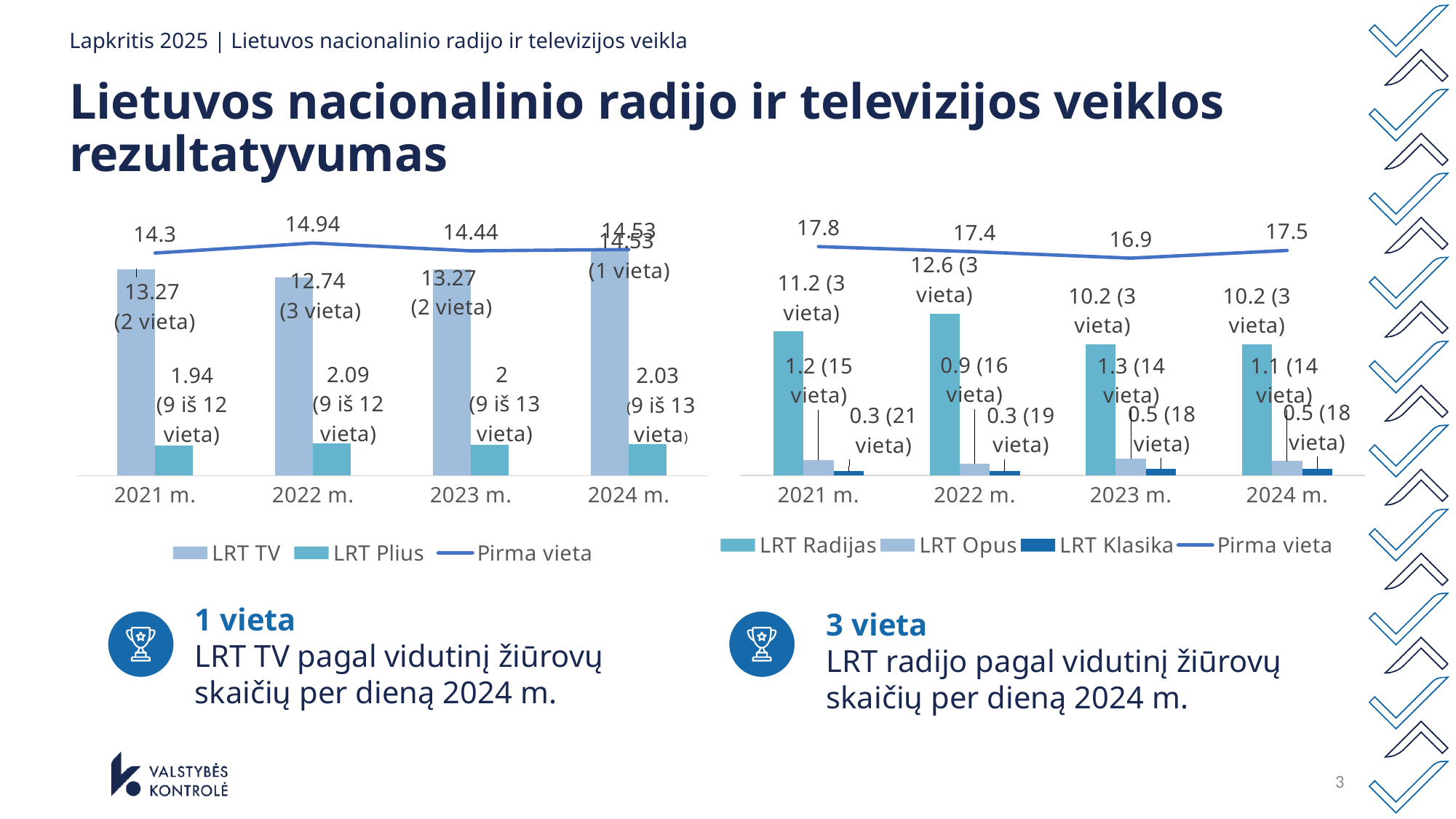
In the left chart, what is the value of the Pirma vieta line in 2022 m.? 14.94 In the left chart, what is the value for LRT TV in 2024 m.? 14.53 In the left chart, what is the value for LRT Plius in 2022 m.? 2.09 In the right chart, what is the value for LRT Radijas in 2022 m.? 12.6 In the left chart, how many series does the legend list? 3 In the right chart, how many years are shown on the x axis? 4 What kind of chart is the right chart? Combined bar and line chart In the left chart, what is the difference between the LRT TV values in 2024 m. and 2023 m.? 1.26 In the right chart, what is the value of the Pirma vieta line in 2023 m.? 16.9 In the right chart, which is larger in 2021 m.: LRT Radijas or LRT Opus? LRT Radijas In the left chart, in which year is the LRT TV value lowest? 2022 m. In the right chart, in which year is the LRT Radijas value highest? 2022 m.